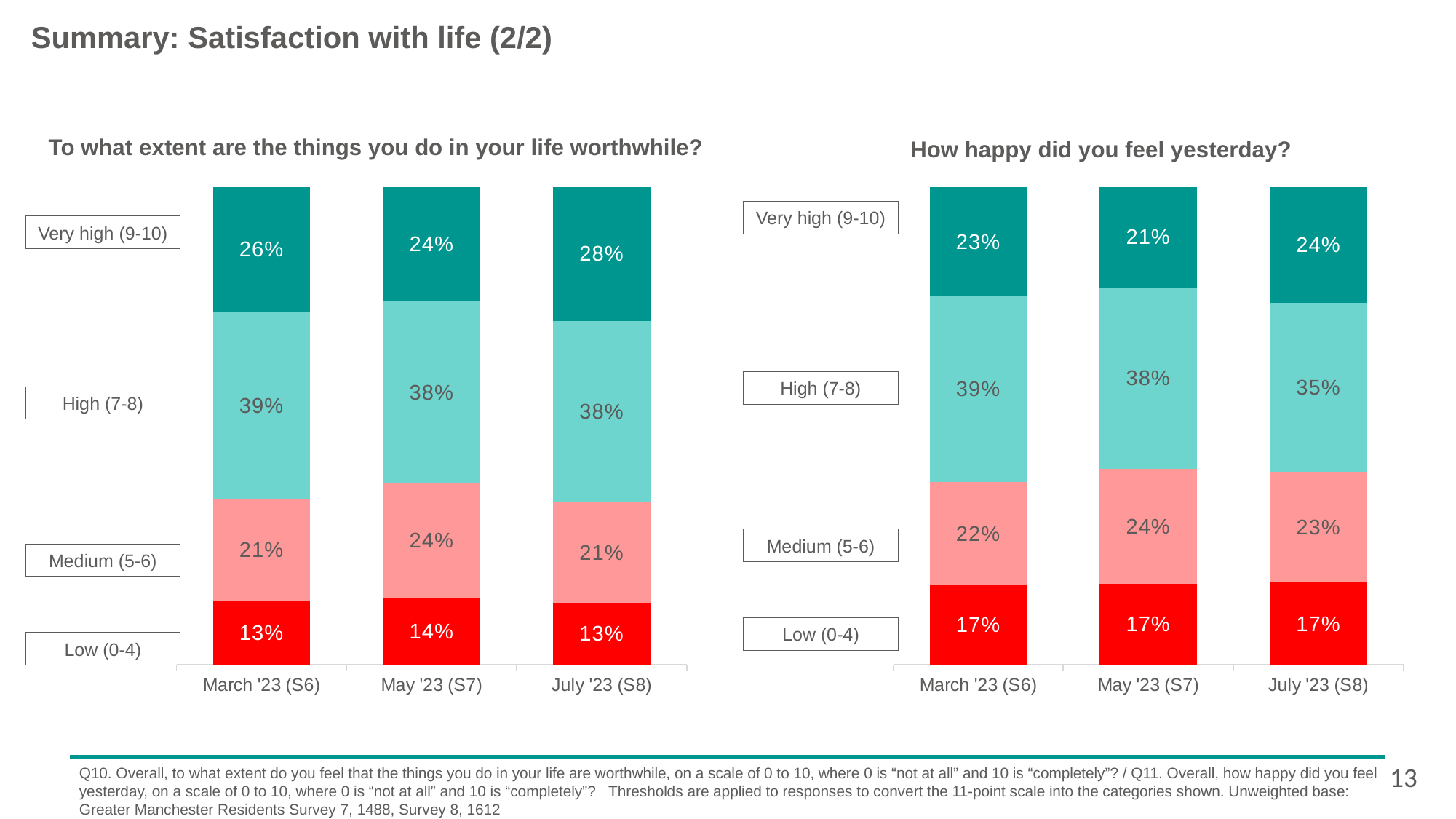
In the chart 'To what extent are the things you do in your life worthwhile?', what is the difference between the Medium (5-6) values for May '23 (S7) and March '23 (S6)? 3 percentage points In the chart 'How happy did you feel yesterday?', which survey wave has the lowest High (7-8) value? July '23 (S8) What type of chart is used for 'How happy did you feel yesterday?'? Stacked bar chart In the chart 'How happy did you feel yesterday?', what is the High (7-8) value for May '23 (S7)? 38% In the chart 'How happy did you feel yesterday?', is the Very high (9-10) value larger for March '23 (S6) or May '23 (S7)? March '23 (S6) How many response categories are stacked in each bar of the chart 'How happy did you feel yesterday?'? 4 How many survey waves (bars) are shown in the chart 'To what extent are the things you do in your life worthwhile?'? 3 In the chart 'To what extent are the things you do in your life worthwhile?', what is the total of the stacked bar for May '23 (S7)? 100% In the chart 'How happy did you feel yesterday?', what is the Low (0-4) value for March '23 (S6)? 17% In the chart 'To what extent are the things you do in your life worthwhile?', which survey wave has the highest Very high (9-10) value? July '23 (S8) In the chart 'How happy did you feel yesterday?', which colour is used for the Low (0-4) category? Red In the chart 'To what extent are the things you do in your life worthwhile?', what is the Very high (9-10) value for July '23 (S8)? 28%